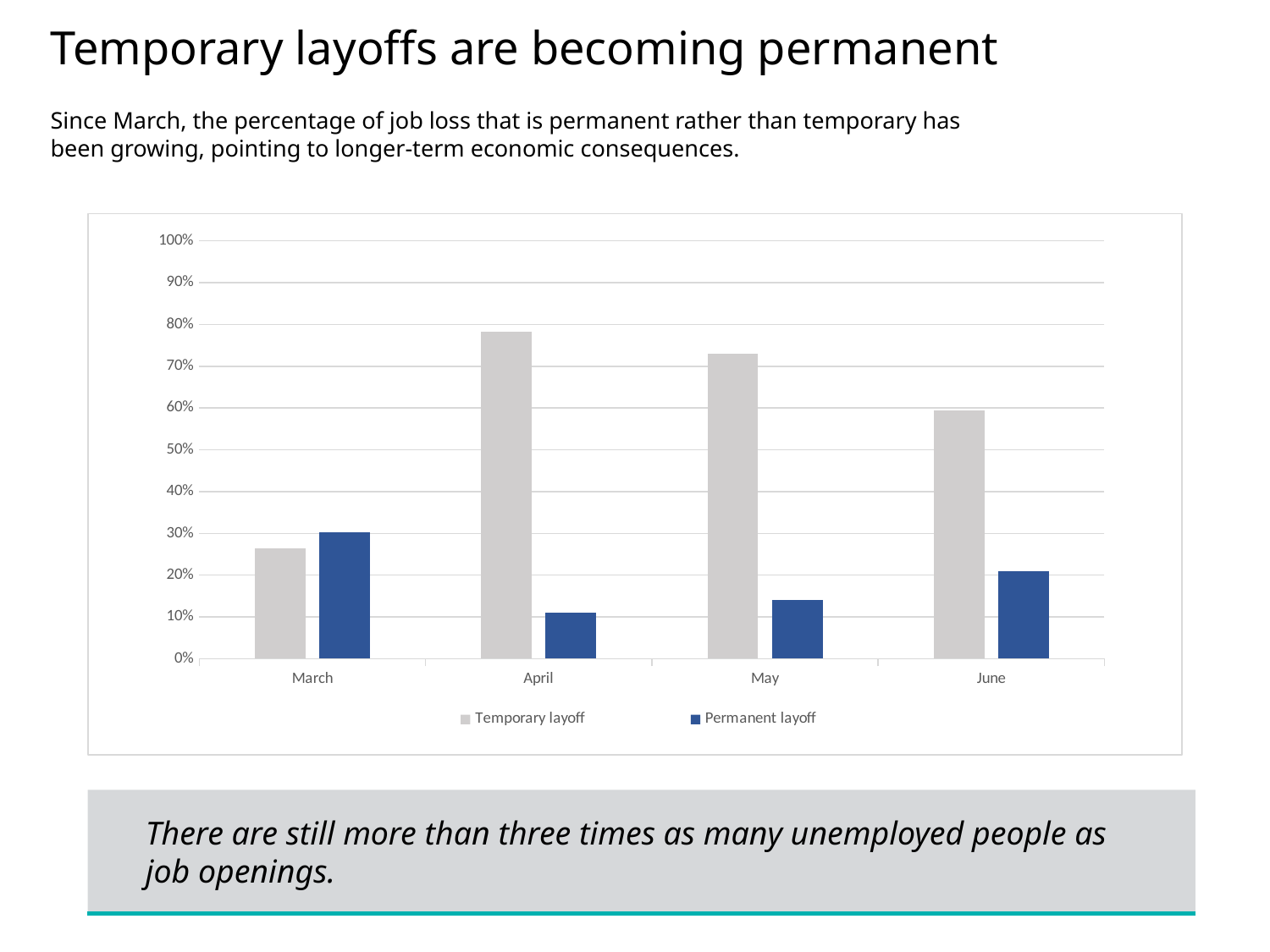
In March, which is larger: Temporary layoff or Permanent layoff? Permanent layoff Which series is shown in blue in the legend? Permanent layoff Which month has the highest Temporary layoff value? April Which month has the lowest Temporary layoff value? March In April, which is larger: Temporary layoff or Permanent layoff? Temporary layoff How many series does the legend list? 2 How many months are shown on the x axis? 4 Is the Temporary layoff value for April greater or less than 70%? greater What kind of chart is shown on the slide? Bar chart Is the Permanent layoff value for April greater or less than 20%? less Which month has the highest Permanent layoff value? March Do the Permanent layoff values rise or fall from April to June? Rise